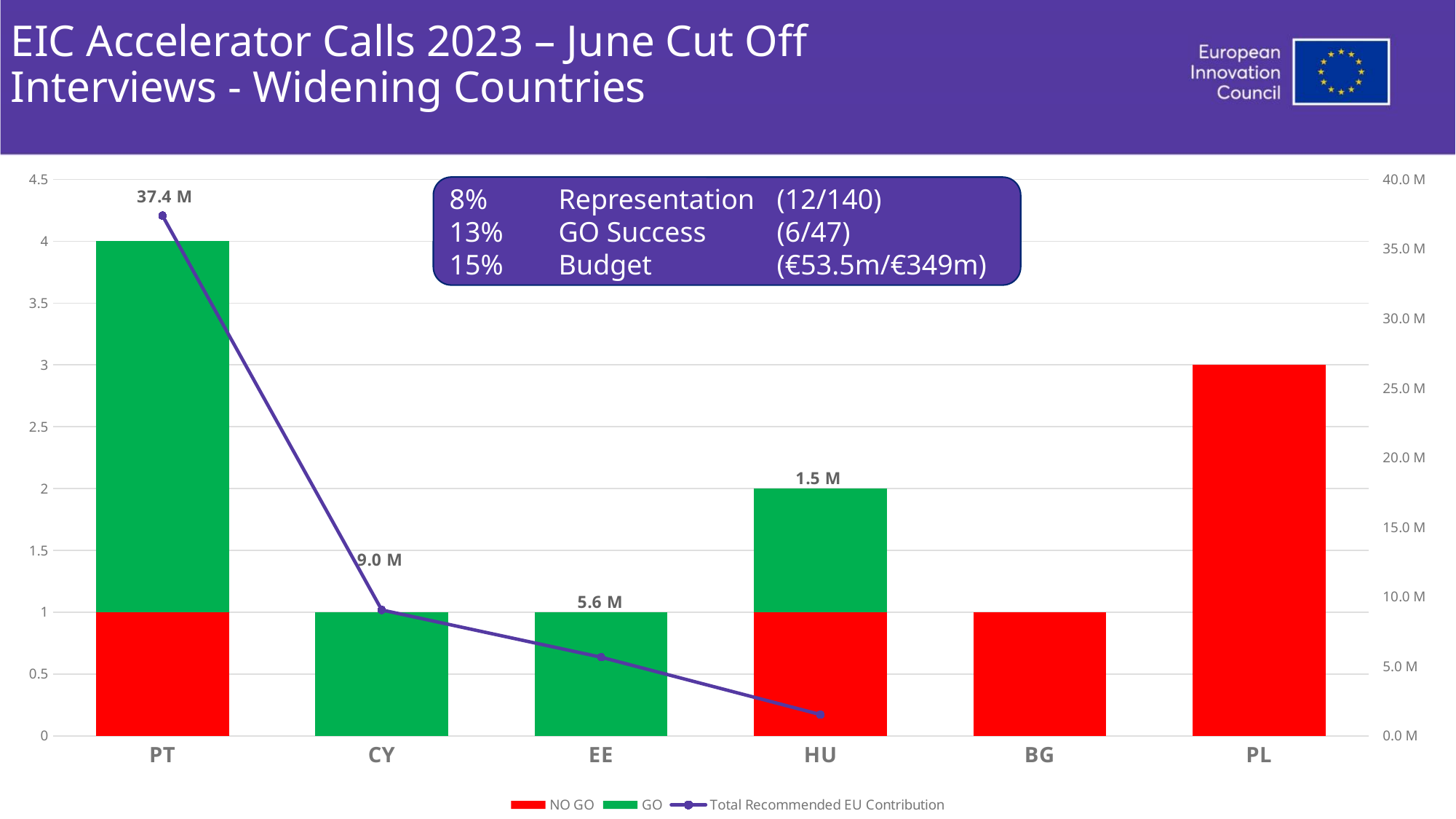
What is the difference between the Total Recommended EU Contribution for PT and for CY? 28.4 M Which country has the larger NO GO value, PL or BG? PL What is the Total Recommended EU Contribution for PT? 37.4 M What is the Total Recommended EU Contribution for EE? 5.6 M What is the Total Recommended EU Contribution for HU? 1.5 M Which country has the highest Total Recommended EU Contribution? PT Does the Total Recommended EU Contribution line rise or fall from PT to HU? fall How many countries are shown on the x axis? 6 What colour represents the GO series in the legend? Green How many series does the legend list? 3 Among the countries with a labelled Total Recommended EU Contribution, which has the lowest value? HU What is the total height of the stacked bar for PT (NO GO plus GO)? 4